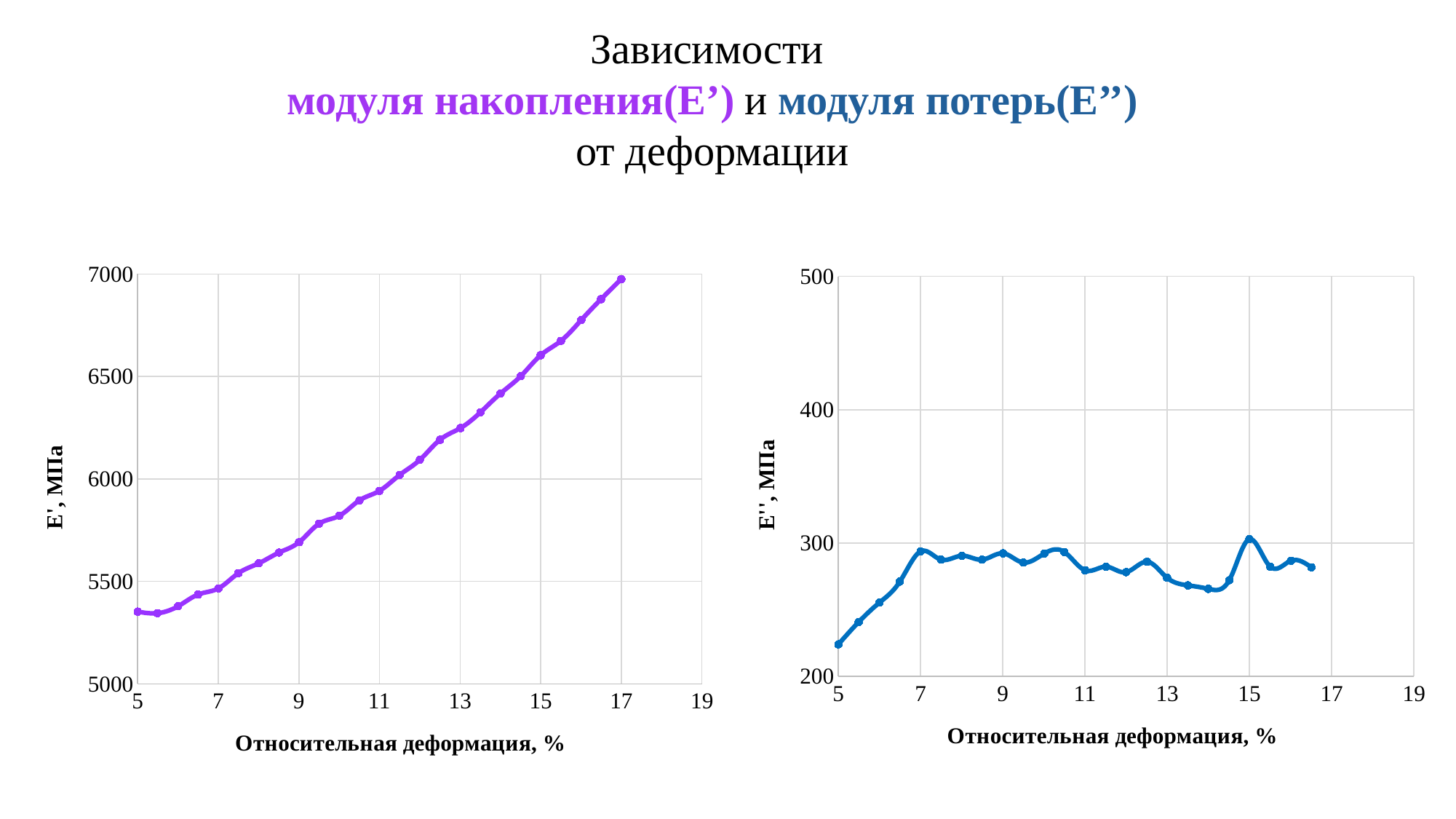
In the left chart (E', МПа), is the value at a relative deformation of 11% greater or less than 6000? less In the left chart (E', МПа), do the values rise or fall as relative deformation increases from 5 to 17? rise What colour is the line in the right chart (E'', МПа)? blue What kind of chart is the right chart (E'', МПа)? line chart What is the x-axis title of the left chart? Относительная деформация, % In the right chart (E'', МПа), is the value at a relative deformation of 5% greater or less than 250? less In the left chart (E', МПа), is the value at a relative deformation of 5% greater or less than 5500? less What kind of chart is the left chart (E', МПа)? line chart In the right chart (E'', МПа), at which relative deformation value is E'' lowest? 5 In the left chart (E', МПа), at which relative deformation value is E' highest? 17